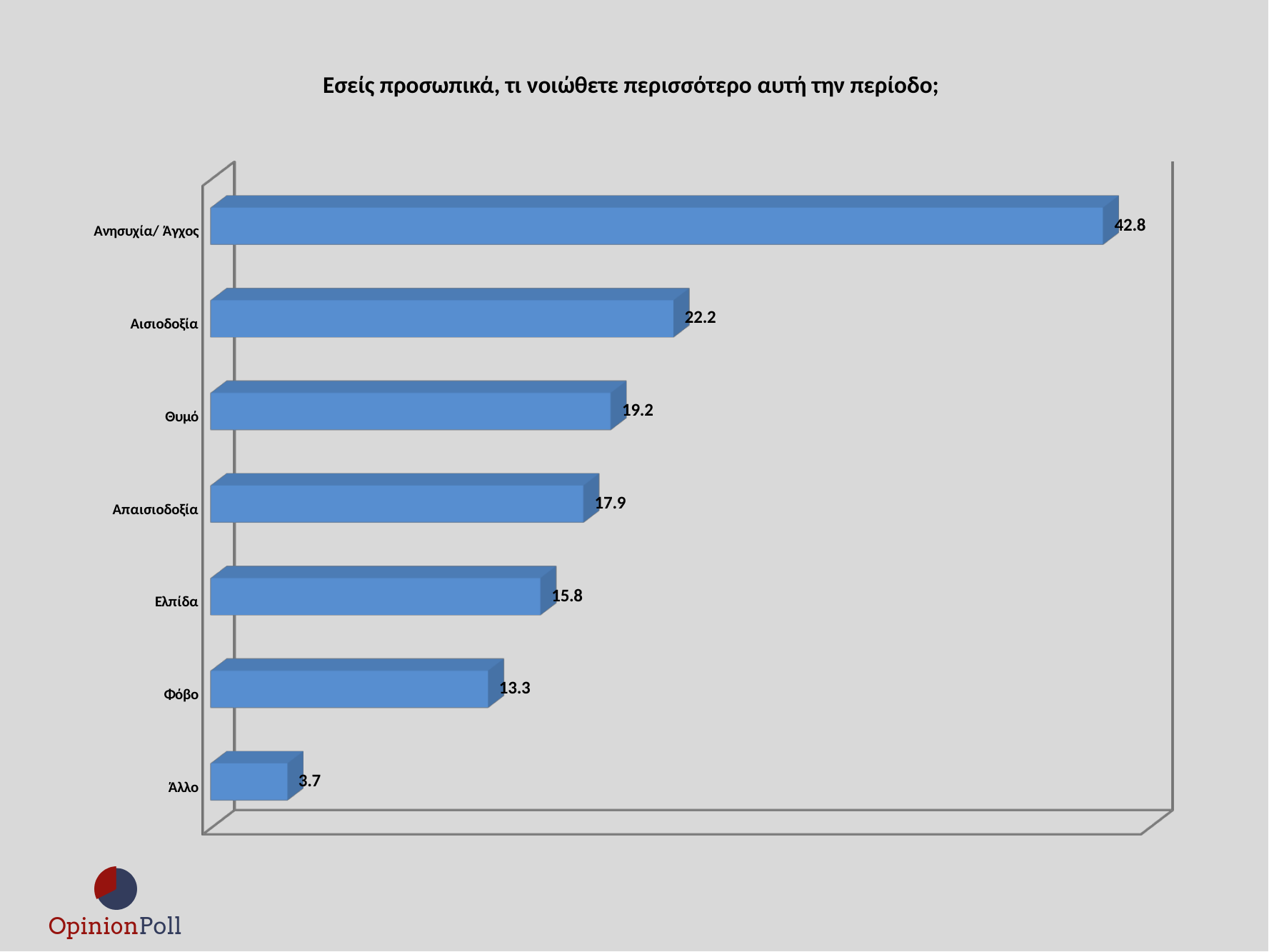
What is the value for Ανησυχία/ Άγχος? 42.8 What is the difference between the values for Απαισιοδοξία and Φόβο? 4.6 Which category has the highest value? Ανησυχία/ Άγχος What is the value for Ελπίδα? 15.8 What kind of chart is shown on the slide? Bar chart What is the value for Αισιοδοξία? 22.2 How many categories are shown in the chart? 7 What is the value for Θυμό? 19.2 What is the value for Άλλο? 3.7 Which is larger, the value for Θυμό or the value for Απαισιοδοξία? Θυμό What is the difference between the values for Ανησυχία/ Άγχος and Αισιοδοξία? 20.6 Which category has the lowest value? Άλλο